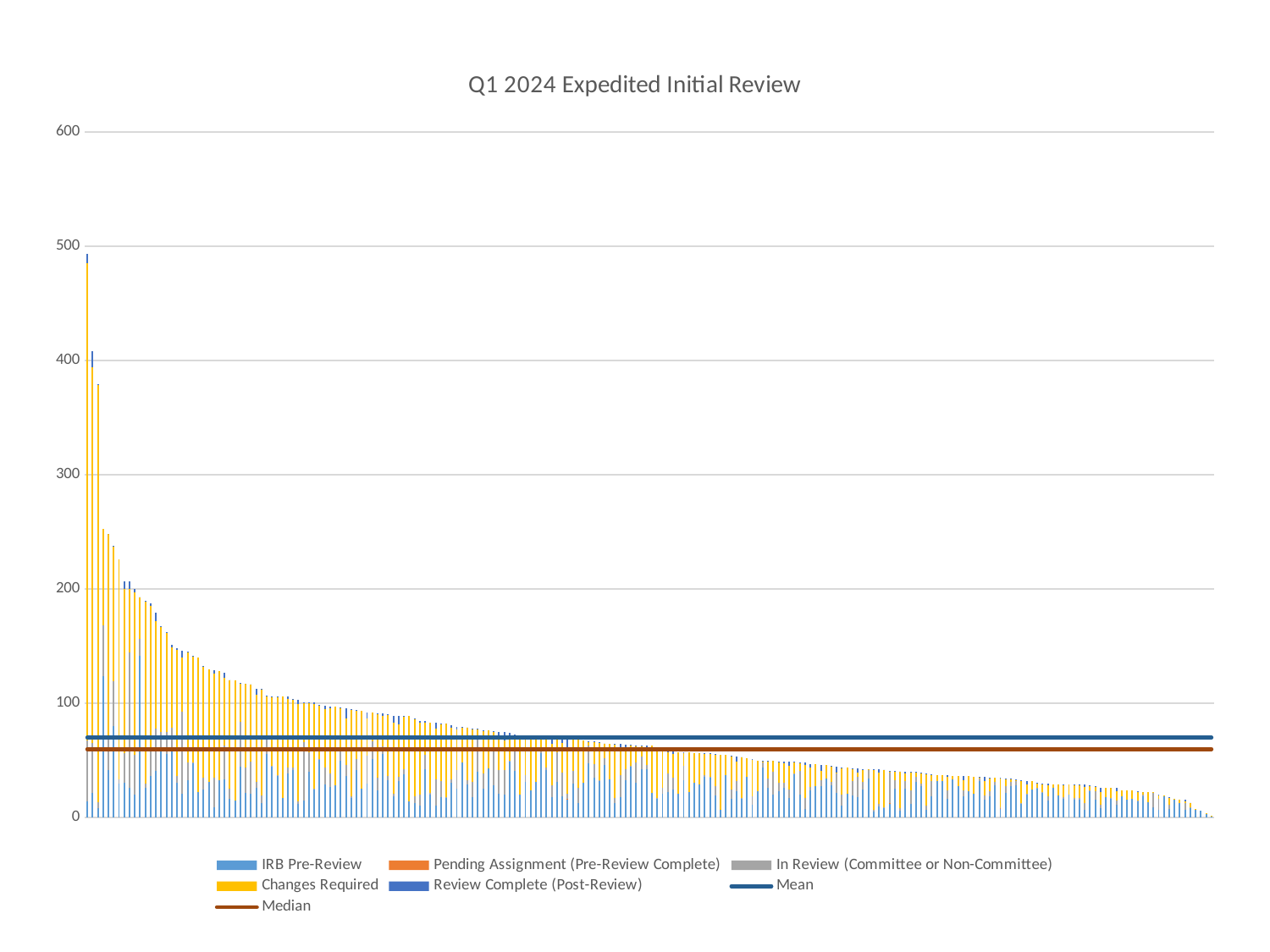
What kind of chart is shown on the slide? Stacked bar chart with Mean and Median lines Is the tallest bar in the chart greater or less than 400? greater Are the bars at the far right of the chart greater or less than 100? less What is the highest value shown on the y axis? 600 Do the bar heights rise or fall moving from left to right along the x axis? Fall How many entries does the chart's legend list? 7 Is the Mean line greater or less than 100 on the y axis? less What is the title of the chart? Q1 2024 Expedited Initial Review Which horizontal line sits higher on the chart, Mean or Median? Mean